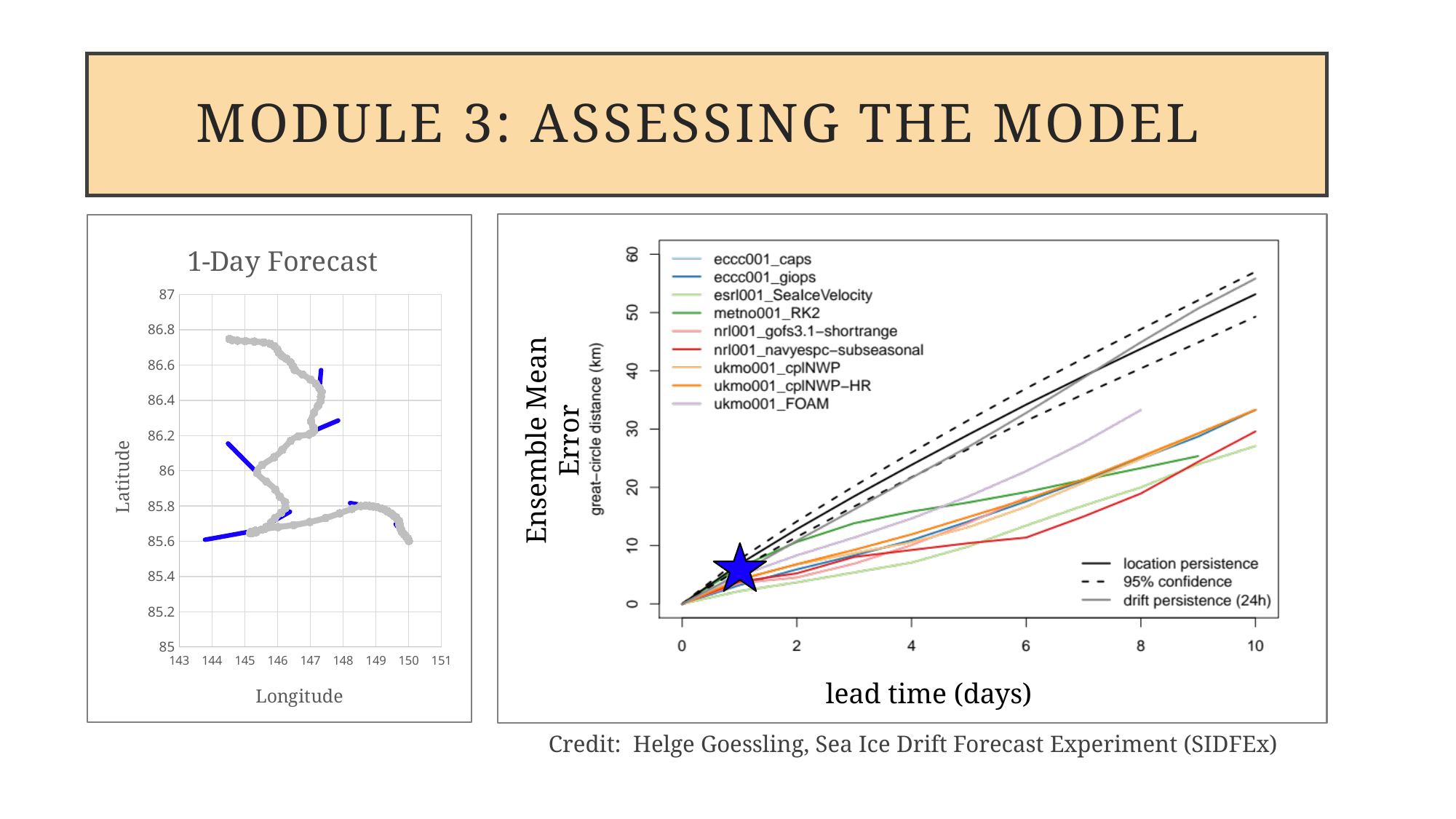
In the right-hand chart, is the esrl001_SeaIceVelocity value at a lead time of 10 days greater or less than 30? less In the left-hand chart, what is the highest value shown on the Latitude axis? 87 What kind of chart is the right-hand chart (Ensemble Mean Error vs lead time)? line chart In the right-hand chart, which line style represents the 95% confidence interval? dashed In the right-hand chart, what is the label of the x axis? lead time (days) In the right-hand chart, is the location persistence value at a lead time of 10 days greater or less than 50? greater What is the title of the left-hand chart? 1-Day Forecast In the right-hand chart, do the error values rise or fall as lead time increases? rise In the right-hand chart, is the ukmo001_FOAM value at a lead time of 8 days greater or less than 30? greater In the right-hand chart, how many reference lines does the lower-right legend list? 3 In the right-hand chart, how many model series does the upper legend list? 9 In the right-hand chart, at a lead time of 10 days, which is larger: location persistence or esrl001_SeaIceVelocity? location persistence